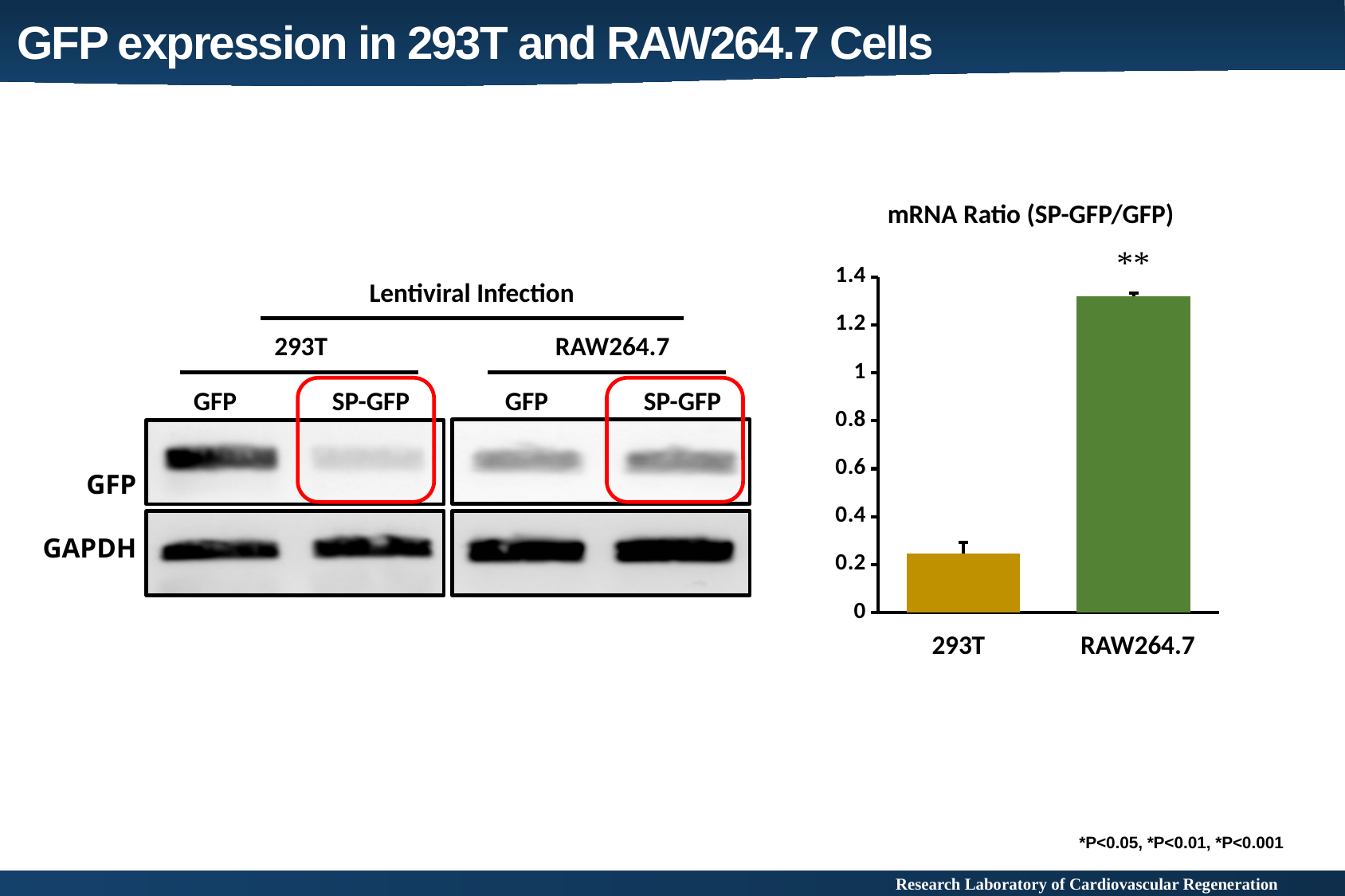
Which category has the highest mRNA ratio in the chart? RAW264.7 What is the title of the chart on the slide? mRNA Ratio (SP-GFP/GFP) Which has a larger mRNA ratio, 293T or RAW264.7? RAW264.7 Which category has the lowest mRNA ratio in the chart? 293T What type of chart is shown on the slide? bar chart What colour is the bar for RAW264.7 in the chart? green Is the mRNA ratio for RAW264.7 greater or less than 1.2? greater Is the mRNA ratio for RAW264.7 greater or less than 1? greater How many categories are plotted in the bar chart? 2 Is the mRNA ratio for 293T greater or less than 0.4? less Do the bar values rise or fall going from 293T to RAW264.7 along the x axis? rise